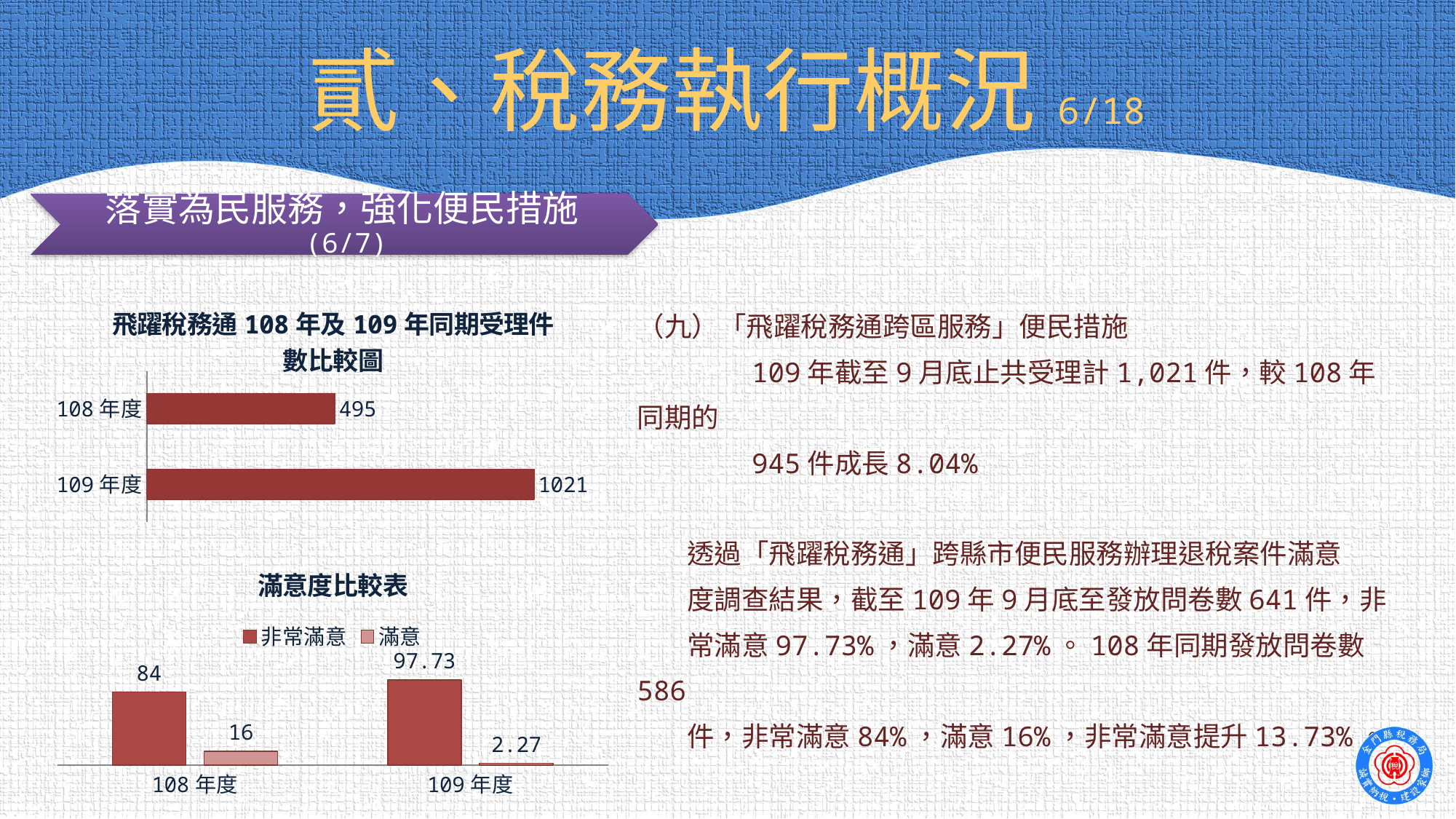
What kind of chart is the top chart titled 飛躍稅務通 108 年及 109 年同期受理件數比較圖? bar chart In the bottom chart titled 滿意度比較表, which is larger: 非常滿意 for 108 年度 or 非常滿意 for 109 年度? 109 年度 In the bottom chart titled 滿意度比較表, what is the value of 非常滿意 for 109 年度? 97.73 In the top chart titled 飛躍稅務通 108 年及 109 年同期受理件數比較圖, which category has the highest value? 109 年度 How many series does the legend of the bottom chart titled 滿意度比較表 list? 2 In the bottom chart titled 滿意度比較表, what is the value of 滿意 for 109 年度? 2.27 In the bottom chart titled 滿意度比較表, what is the value of 滿意 for 108 年度? 16 In the top chart titled 飛躍稅務通 108 年及 109 年同期受理件數比較圖, what is the value for 109 年度? 1021 In the top chart titled 飛躍稅務通 108 年及 109 年同期受理件數比較圖, what is the difference between the values for 109 年度 and 108 年度? 526 How many categories are shown in the top chart titled 飛躍稅務通 108 年及 109 年同期受理件數比較圖? 2 In the bottom chart titled 滿意度比較表, what is the difference between the 非常滿意 values for 109 年度 and 108 年度? 13.73 In the top chart titled 飛躍稅務通 108 年及 109 年同期受理件數比較圖, what is the value for 108 年度? 495